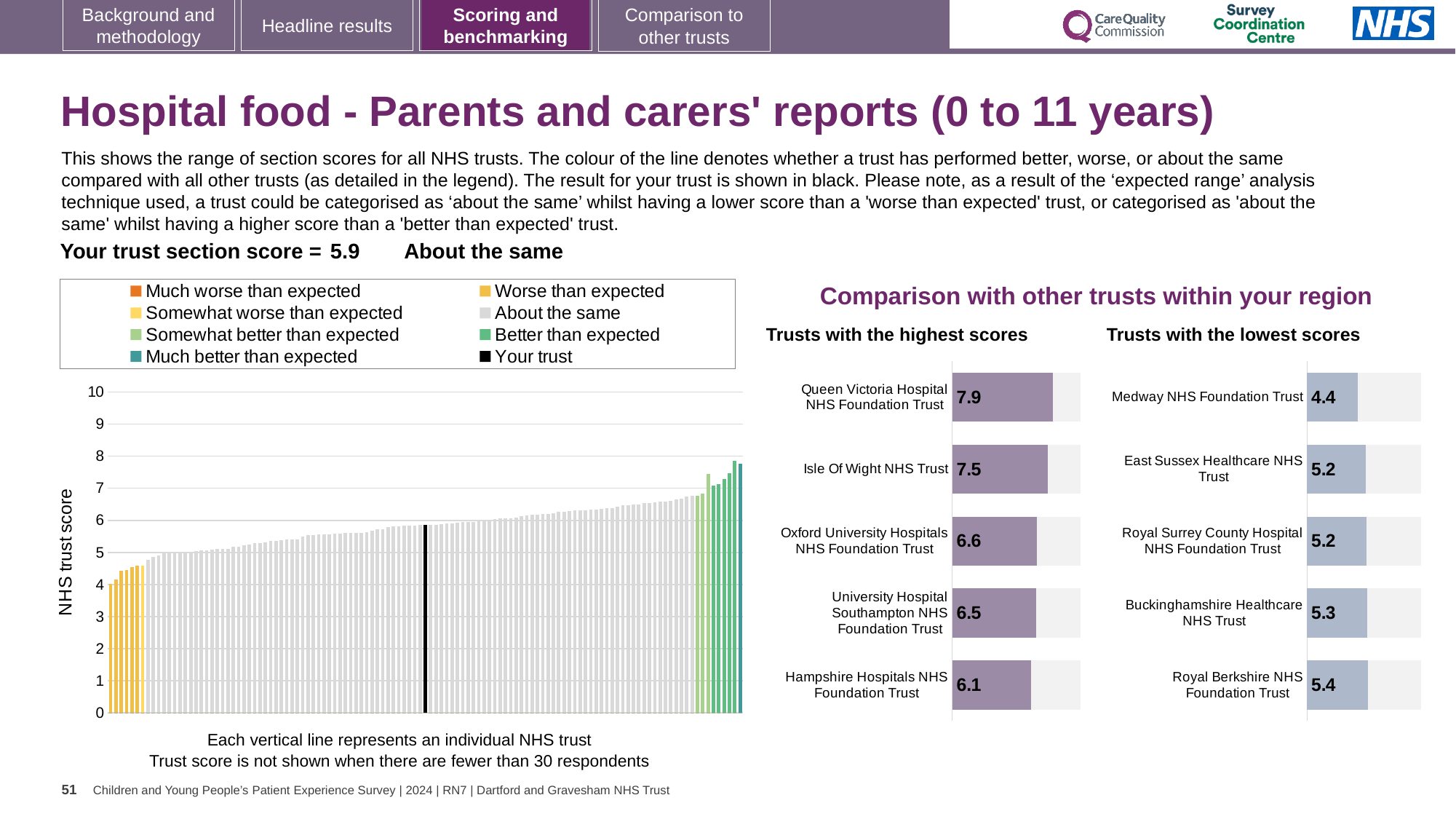
In the 'Trusts with the lowest scores' chart, what is the score for Medway NHS Foundation Trust? 4.4 In the 'Trusts with the highest scores' chart, what is the score for Queen Victoria Hospital NHS Foundation Trust? 7.9 In the main 'NHS trust score' chart on the left, do the trust scores rise or fall from left to right? rise In the main 'NHS trust score' chart on the left, what is the section score for your trust? 5.9 In the 'Trusts with the lowest scores' chart, what is the difference between the scores of Royal Berkshire NHS Foundation Trust and Medway NHS Foundation Trust? 1.0 In the 'Trusts with the highest scores' chart, which trust has the highest score? Queen Victoria Hospital NHS Foundation Trust In the 'Trusts with the highest scores' chart, what is the score for Hampshire Hospitals NHS Foundation Trust? 6.1 How many entries does the legend of the main 'NHS trust score' chart list? 8 In the 'Trusts with the lowest scores' chart, which has the larger score: Medway NHS Foundation Trust or Royal Berkshire NHS Foundation Trust? Royal Berkshire NHS Foundation Trust In the 'Trusts with the highest scores' chart, how many trusts are shown? 5 In the 'Trusts with the highest scores' chart, what is the difference between the scores of Queen Victoria Hospital NHS Foundation Trust and Hampshire Hospitals NHS Foundation Trust? 1.8 In the 'Trusts with the lowest scores' chart, which trust has the lowest score? Medway NHS Foundation Trust